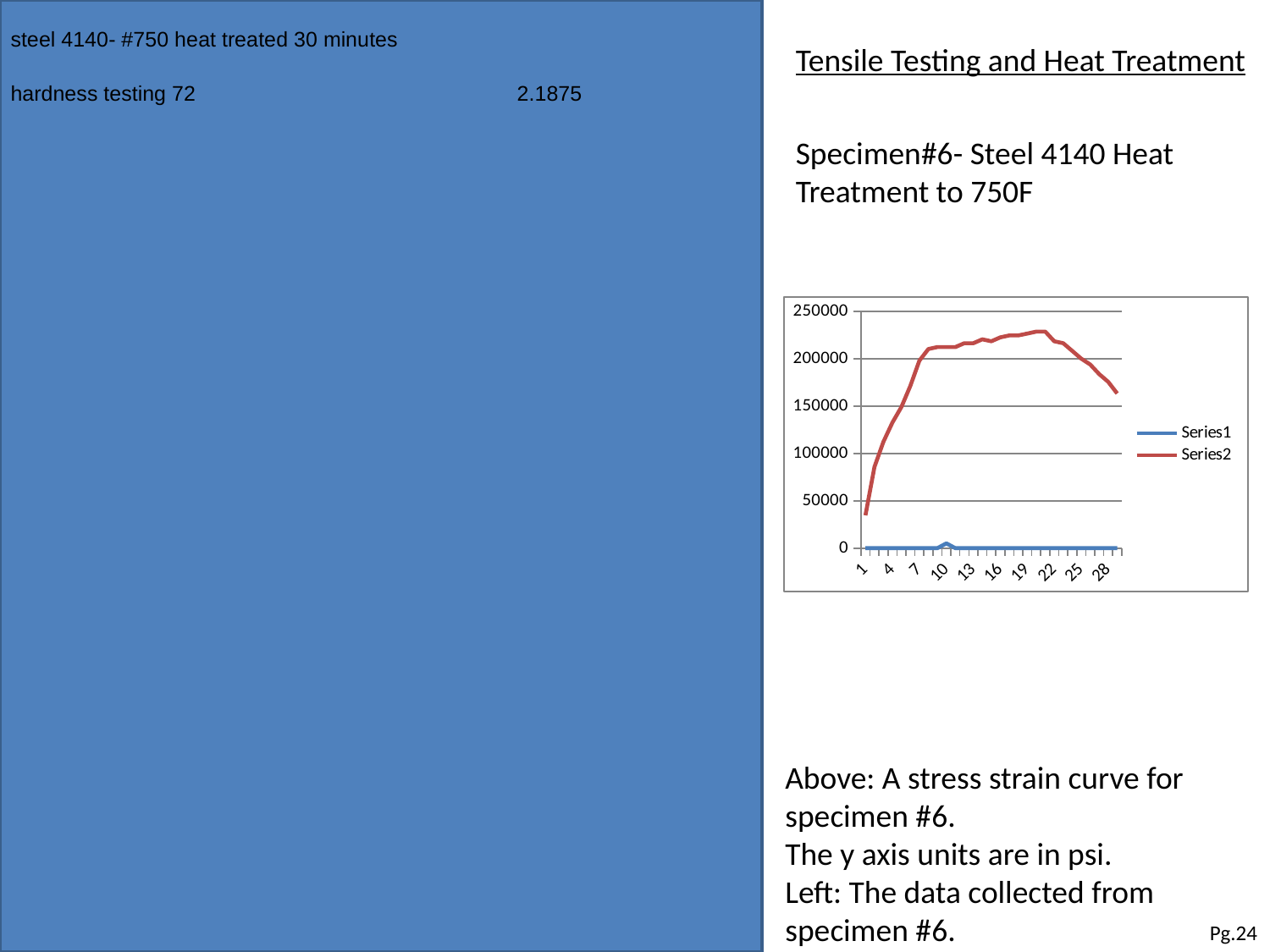
Does Series2 rise or fall between x = 1 and x = 7? rise Which series has the larger value at x = 13, Series1 or Series2? Series2 Does Series2 rise or fall between x = 22 and x = 28? fall Is the value of Series2 at x = 7 greater or less than 150000? greater What is the highest value labelled on the chart's y axis? 250000 Which series reaches the highest value in the chart? Series2 What kind of chart is shown on the slide? line chart Is the value of Series2 at x = 22 greater or less than 200000? greater How many series does the chart legend list? 2 Is the value of Series1 at x = 16 greater or less than 50000? less What colour is the line for Series2 in the chart? red